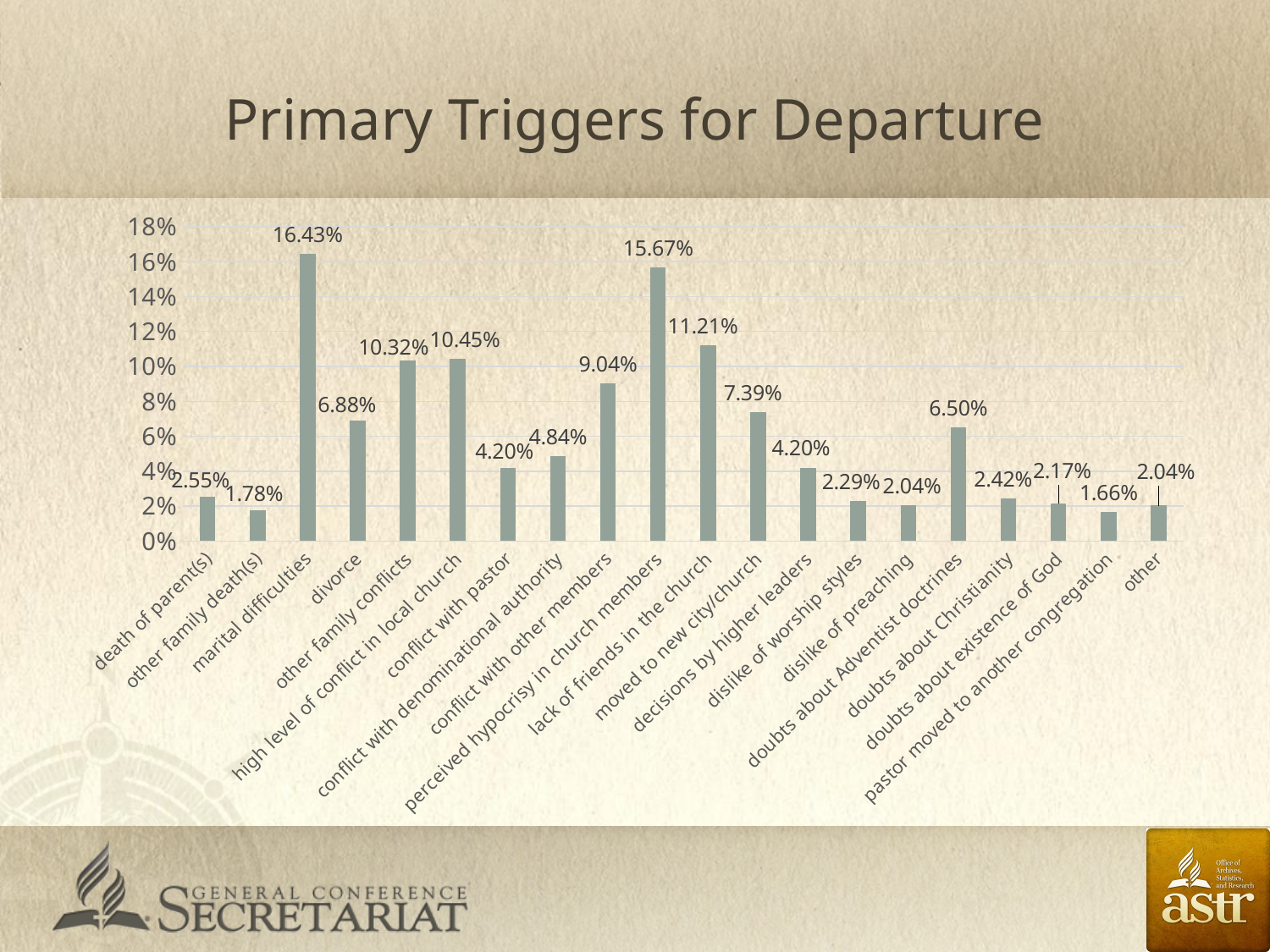
Which trigger has the lowest value? pastor moved to another congregation What is the value for lack of friends in the church? 11.21% What is the difference between lack of friends in the church and moved to new city/church? 3.82 percentage points How many triggers are shown on the chart? 20 What kind of chart is shown on the slide? bar chart Which is larger, divorce or perceived hypocrisy in church members? perceived hypocrisy in church members Is the value for conflict with denominational authority greater or less than 6%? less What is the value for marital difficulties? 16.43% Which trigger has the highest value? marital difficulties What is the difference between marital difficulties and conflict with other members? 7.39 percentage points What is the value for doubts about Adventist doctrines? 6.50% What is the title of the chart? Primary Triggers for Departure